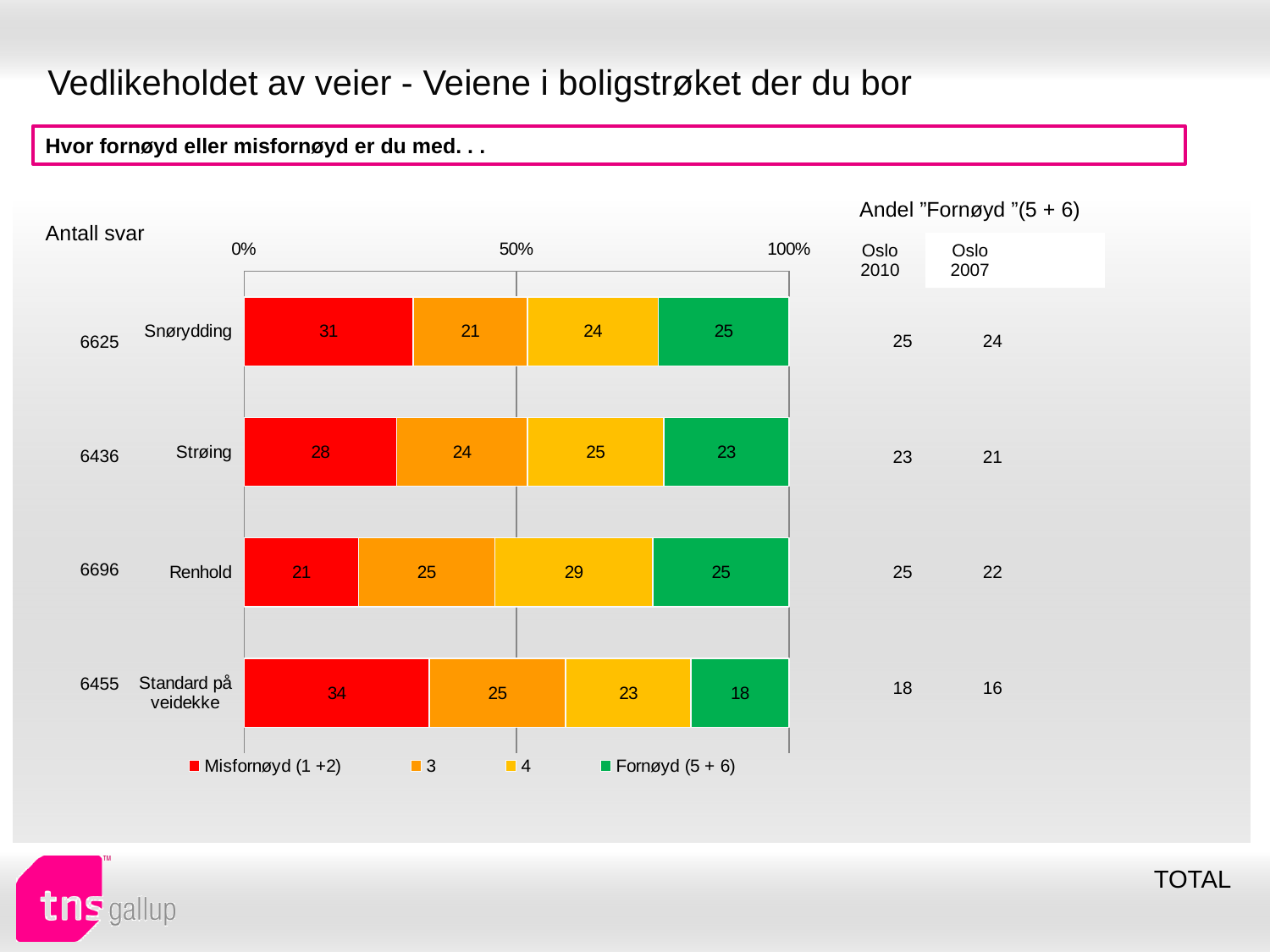
What is the difference between the 'Misfornøyd (1 +2)' values for Standard på veidekke and Renhold? 13 What is the value of 'Fornøyd (5 + 6)' for Standard på veidekke? 18 Which is larger: the 'Misfornøyd (1 +2)' value for Strøing or for Renhold? Strøing What is the value of 'Misfornøyd (1 +2)' for Snørydding? 31 Which category has the lowest 'Fornøyd (5 + 6)' value? Standard på veidekke How many series does the legend list? 4 Which category has the highest 'Misfornøyd (1 +2)' value? Standard på veidekke How many categories are plotted in the chart? 4 What kind of chart is shown on the slide? Stacked bar chart What is the 'Antall svar' (number of responses) shown for Renhold? 6696 What is the total of the stacked bar for Strøing? 100 What is the value of series '4' for Renhold? 29